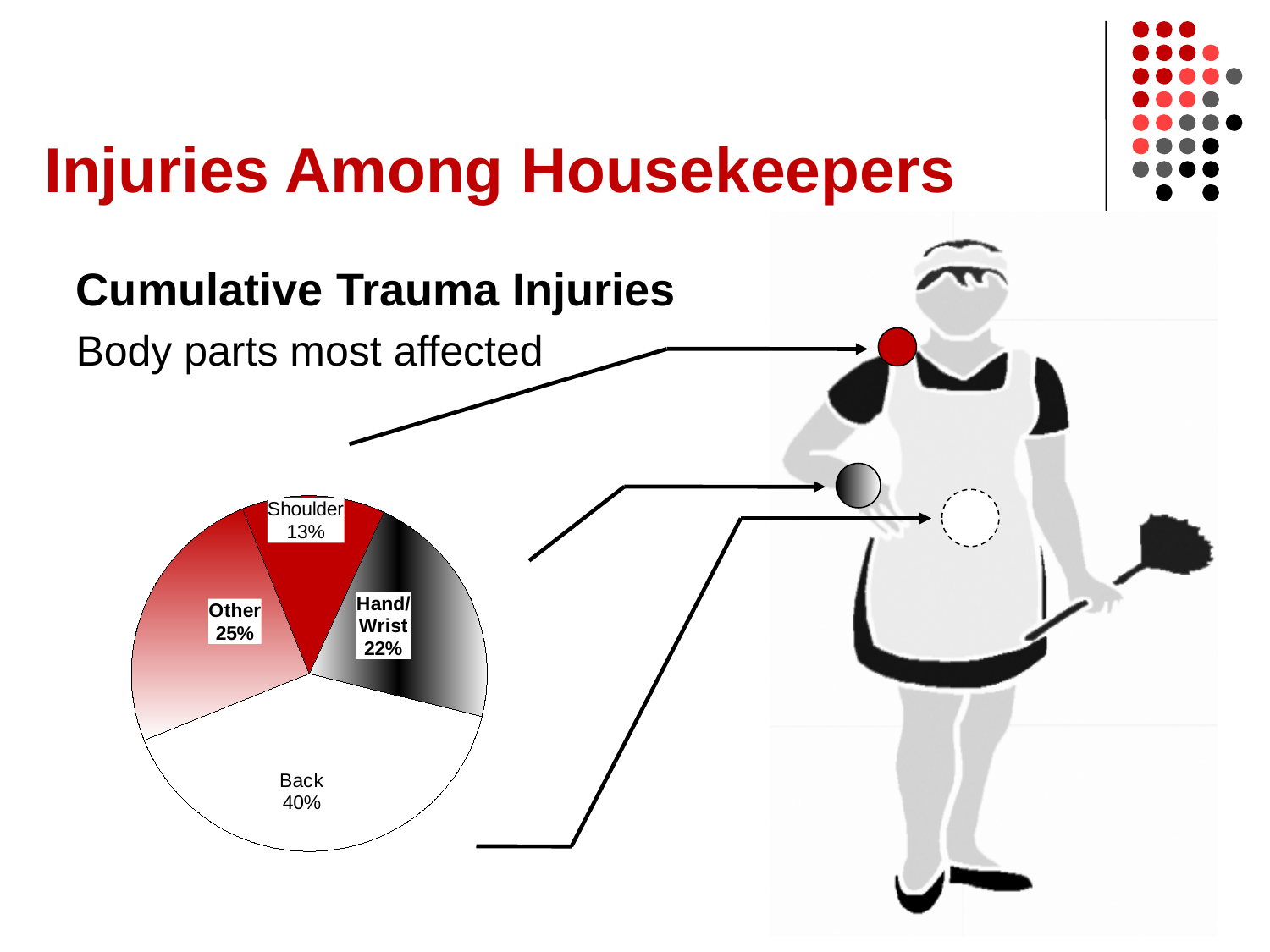
What percentage of cumulative trauma injuries affect the Back? 40% Which slice is larger, Other or Hand/Wrist? Other What percentage of cumulative trauma injuries affect the Shoulder? 13% What percentage of cumulative trauma injuries affect the Hand/Wrist? 22% Which body part has the largest share of cumulative trauma injuries? Back Which body part has the smallest share of cumulative trauma injuries? Shoulder How many slices does the pie chart have? 4 What colour is the Shoulder slice of the pie chart? red What percentage of cumulative trauma injuries fall under Other? 25% What is the difference in percentage points between the Back and Shoulder slices? 27 What kind of chart is shown on the slide? pie chart What is the combined share of the Back and Hand/Wrist slices? 62%